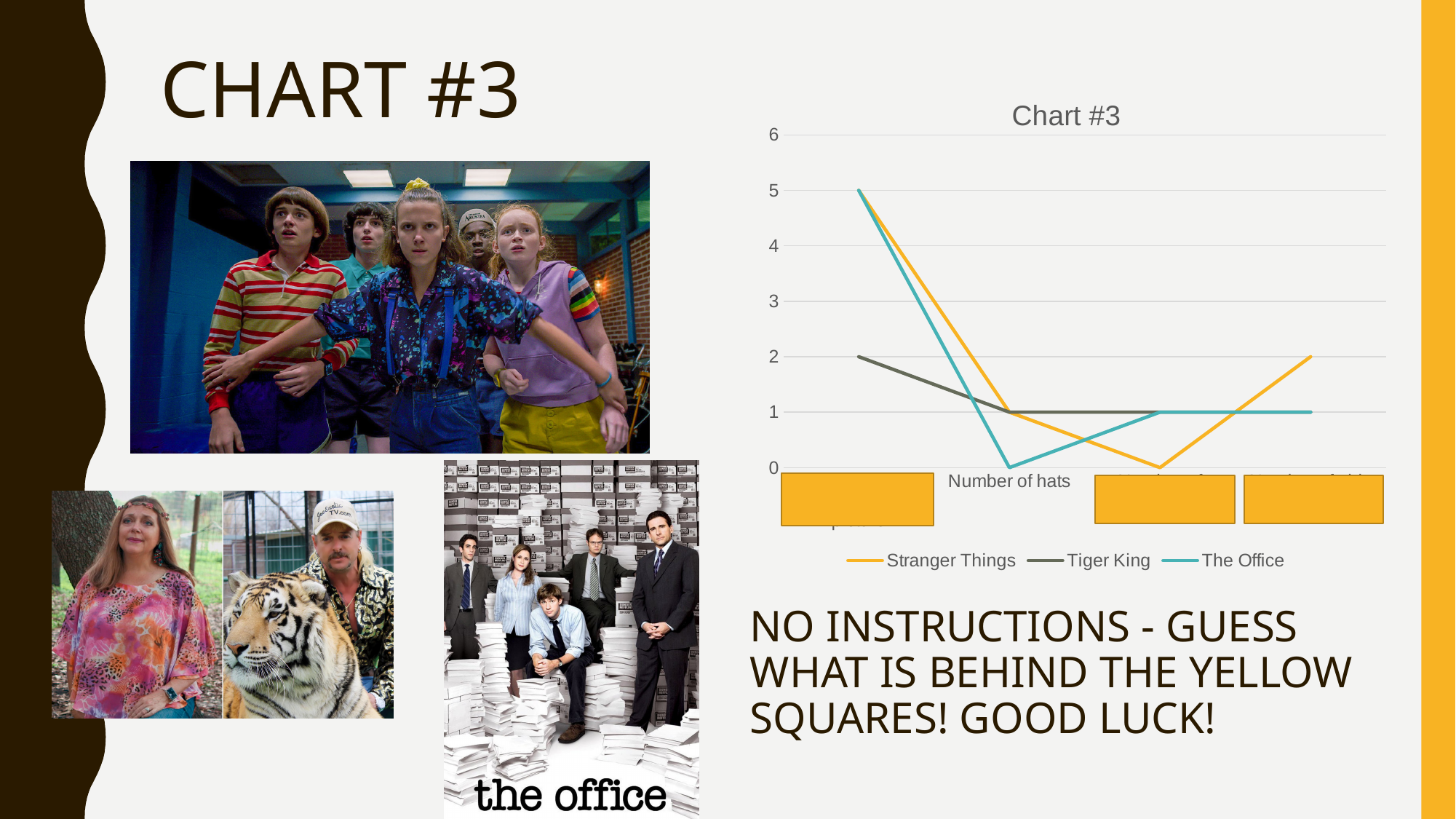
Which series has the lowest value in the "Number of hats" category? The Office What is the value for Tiger King in the "Number of hats" category? 1 What is the value for The Office in the "Number of hats" category? 0 What is the title of the chart? Chart #3 What is the difference between the Stranger Things value and The Office value in the "Number of hats" category? 1 What are the three series named in the chart legend? Stranger Things, Tiger King, The Office What is the value for Stranger Things in the "Number of hats" category? 1 Is the value for Stranger Things in the "Number of hats" category greater or less than 3? less In the "Number of hats" category, which is larger: the value for Stranger Things or the value for The Office? Stranger Things How many series does the legend of the chart list? 3 Does the Stranger Things line rise or fall from the first category to the "Number of hats" category? fall What kind of chart is shown on the slide? line chart